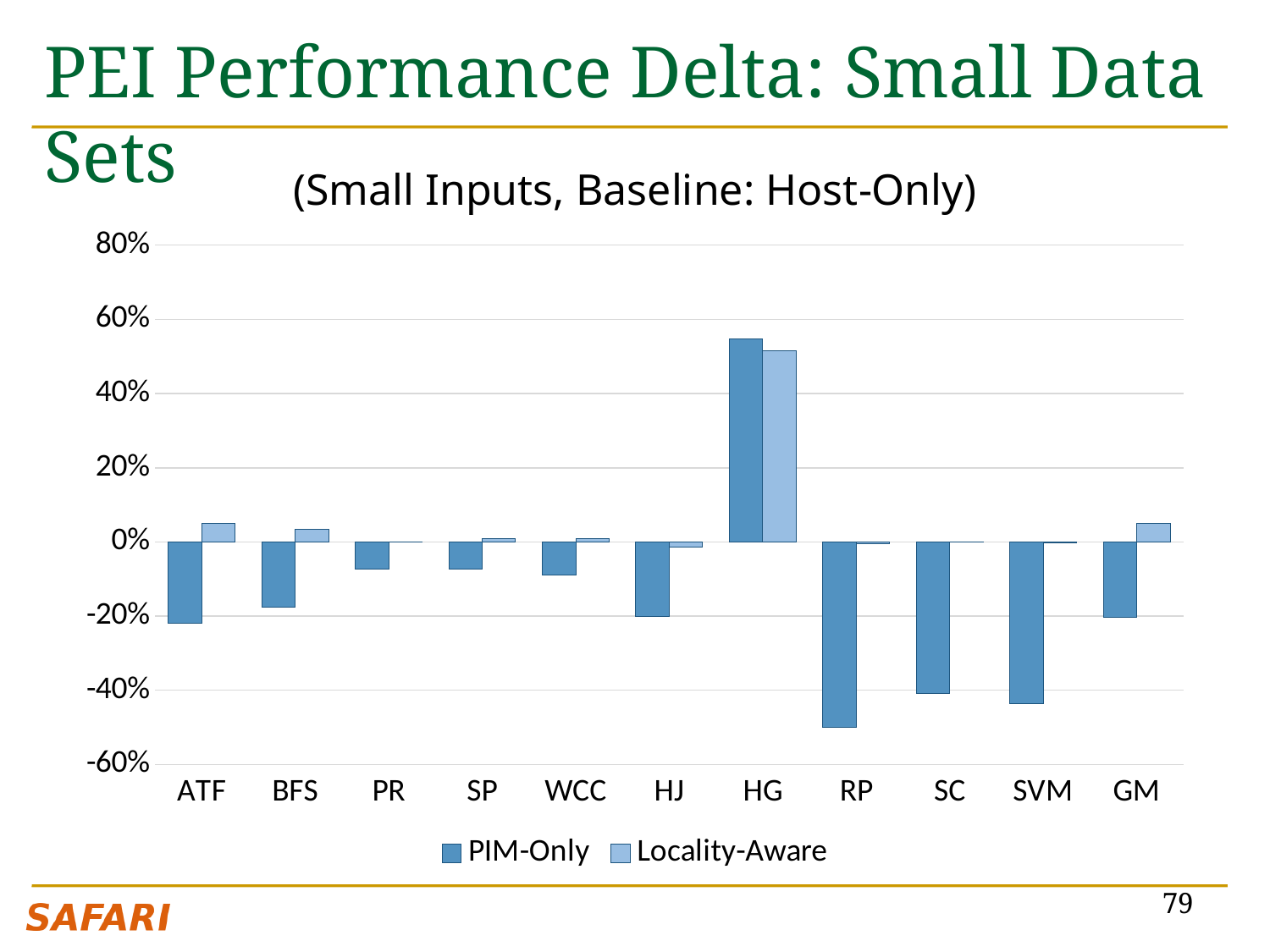
What kind of chart is shown on the slide? bar chart What are the two series named in the legend? PIM-Only and Locality-Aware Which category has the highest Locality-Aware value? HG How many series does the legend list? 2 How many categories are shown on the x axis? 11 Is the PIM-Only value for HG greater or less than 40%? greater Which category has the highest PIM-Only value? HG Is the PIM-Only value for RP greater or less than -40%? less Which is lower, the PIM-Only value for RP or the PIM-Only value for HJ? RP Is the PIM-Only value for PR greater or less than -20%? greater Which category has the lowest PIM-Only value? RP